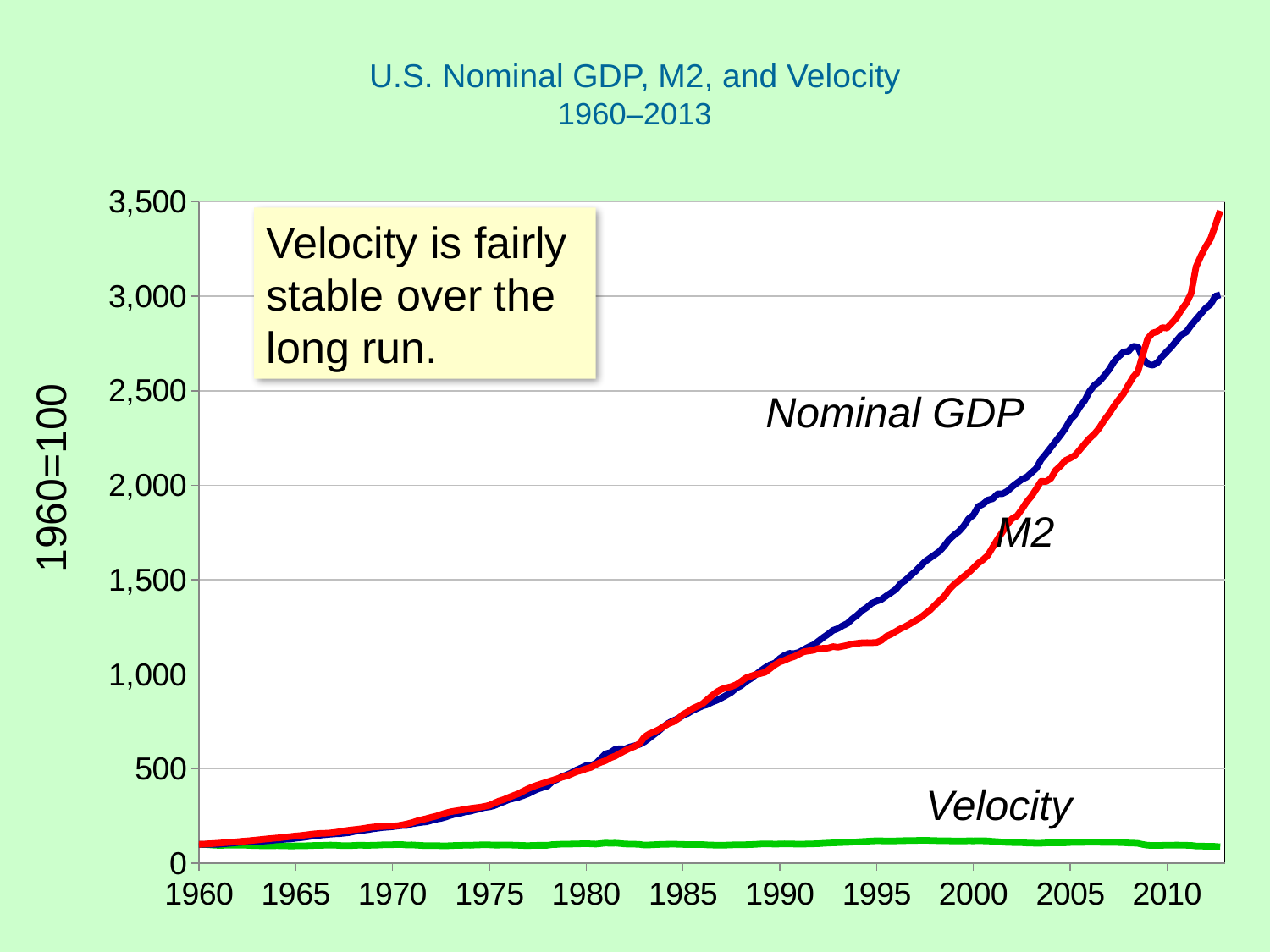
In 1995, which is higher, Nominal GDP or M2? Nominal GDP What kind of chart is shown on the slide? line chart Is the value of Velocity in 2000 greater or less than 500? less What is the title of the chart? U.S. Nominal GDP, M2, and Velocity 1960–2013 Does the Velocity line rise sharply, fall sharply, or stay roughly flat from 1960 to 2013? stays roughly flat Is the value of M2 in 2010 greater or less than 2,500? greater What is the label on the vertical axis of the chart? 1960=100 Is the value of Nominal GDP in 1990 greater or less than 1,500? less Does the Nominal GDP line rise or fall from 1960 to 2013? rises At the end of the period (2013), which is higher, M2 or Nominal GDP? M2 How many data series are labeled on the chart? 3 Which series has the lowest values throughout the whole period? Velocity